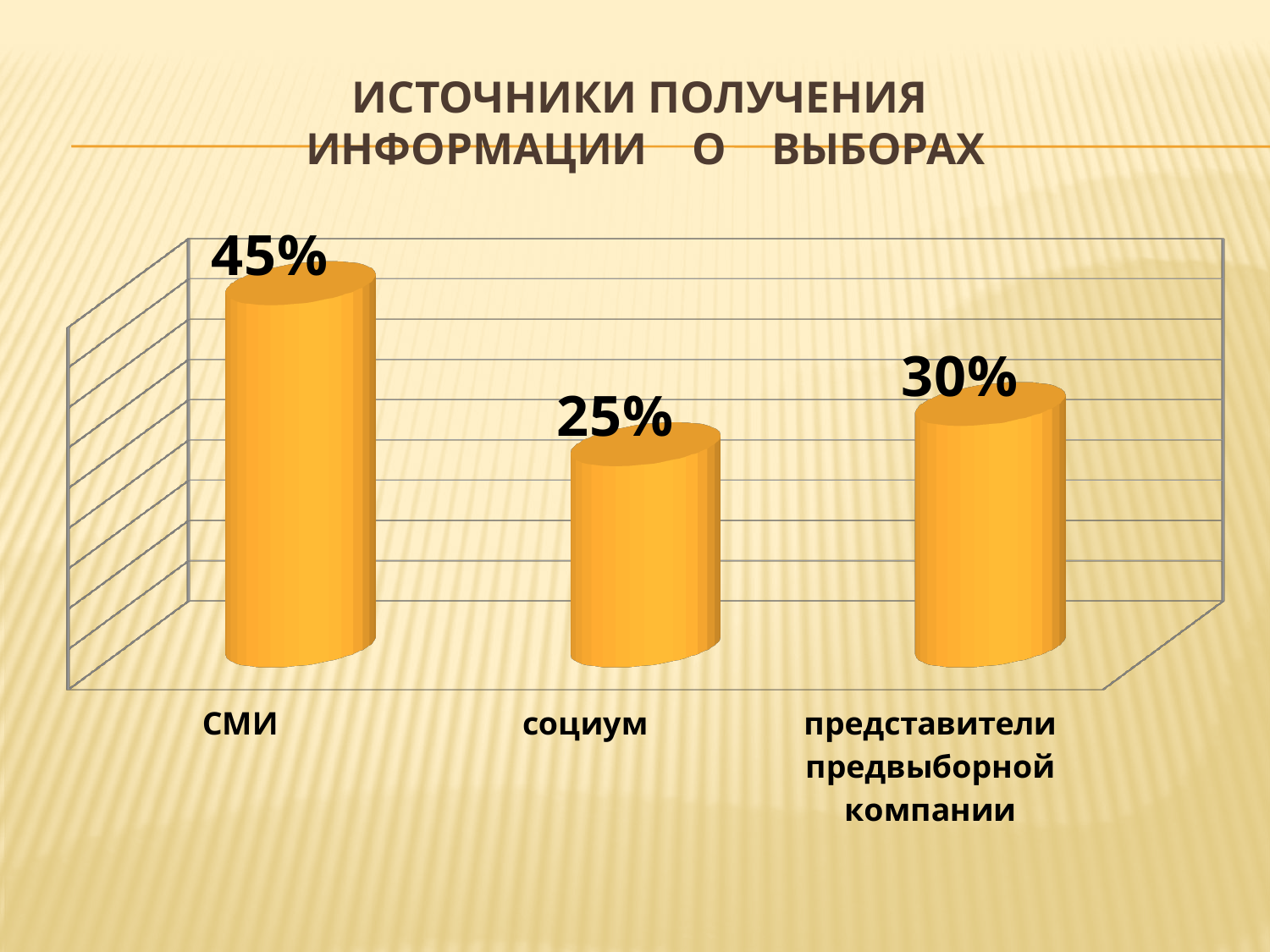
What is the title of the chart? ИСТОЧНИКИ ПОЛУЧЕНИЯ ИНФОРМАЦИИ О ВЫБОРАХ Which category has the lowest value? социум What is the value for социум? 25% What is the difference between the values for представители предвыборной компании and социум? 5% What is the value for СМИ? 45% Which is larger, the value for социум or the value for представители предвыборной компании? представители предвыборной компании How many categories are shown in the chart? 3 What colour are the bars in the chart? orange Which category has the highest value? СМИ What kind of chart is shown on the slide? bar chart What is the value for представители предвыборной компании? 30% What is the difference between the values for СМИ and социум? 20%